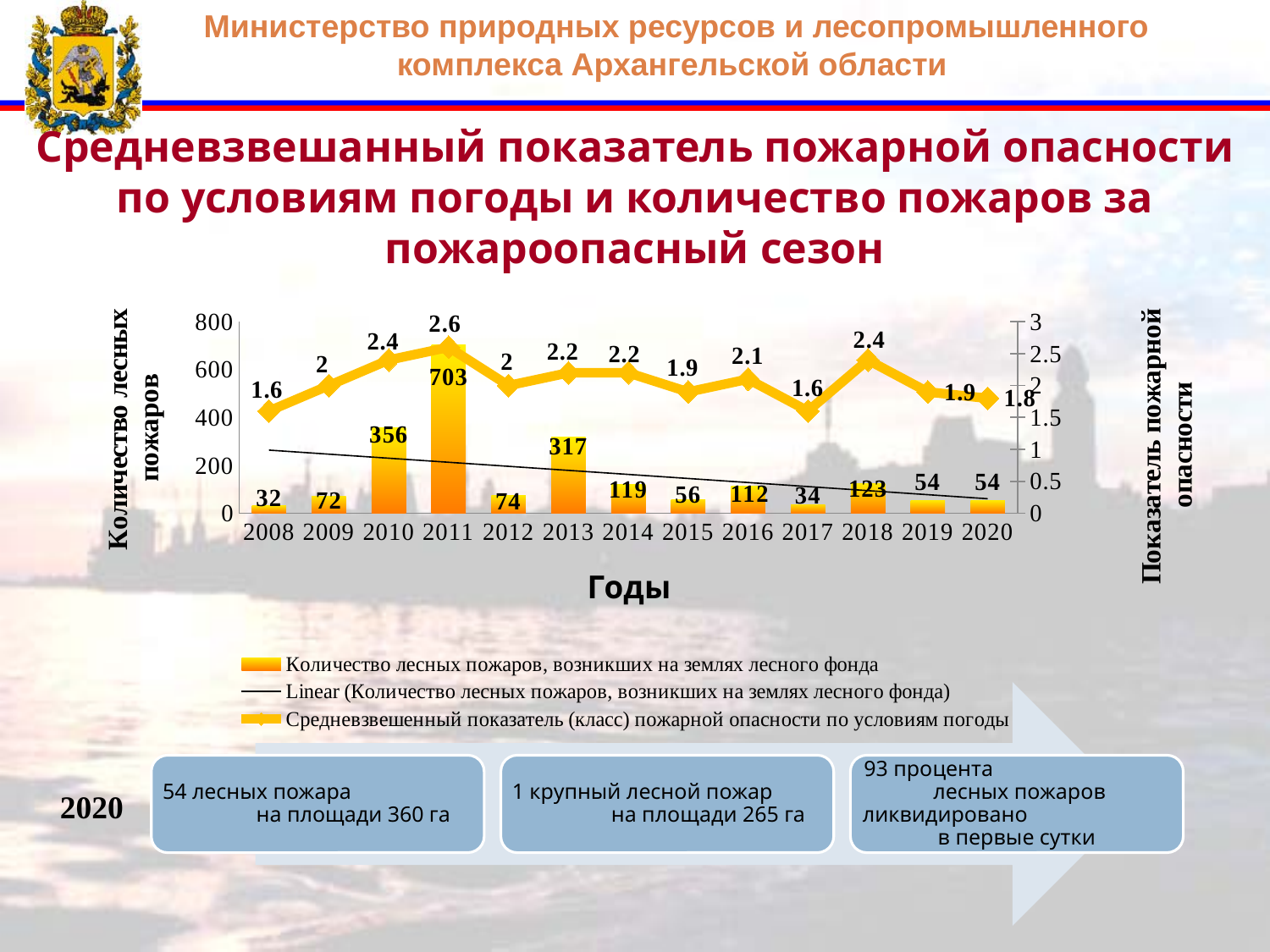
How many entries does the chart legend list? 3 What is the difference in the number of forest fires between 2011 and 2010? 347 How many years are shown on the x axis of the chart? 13 What is the x-axis title of the chart? Годы Which year has the highest weighted fire danger index? 2011 Is the number of forest fires in 2010 greater or less than 200? greater Which year has the lowest number of forest fires? 2008 What is the weighted fire danger index (Средневзвешенный показатель) for 2018? 2.4 What is the weighted fire danger index for 2020? 1.8 Which year had more forest fires, 2013 or 2014? 2013 How many forest fires (Количество лесных пожаров) are shown for 2011? 703 Which year has the highest number of forest fires? 2011